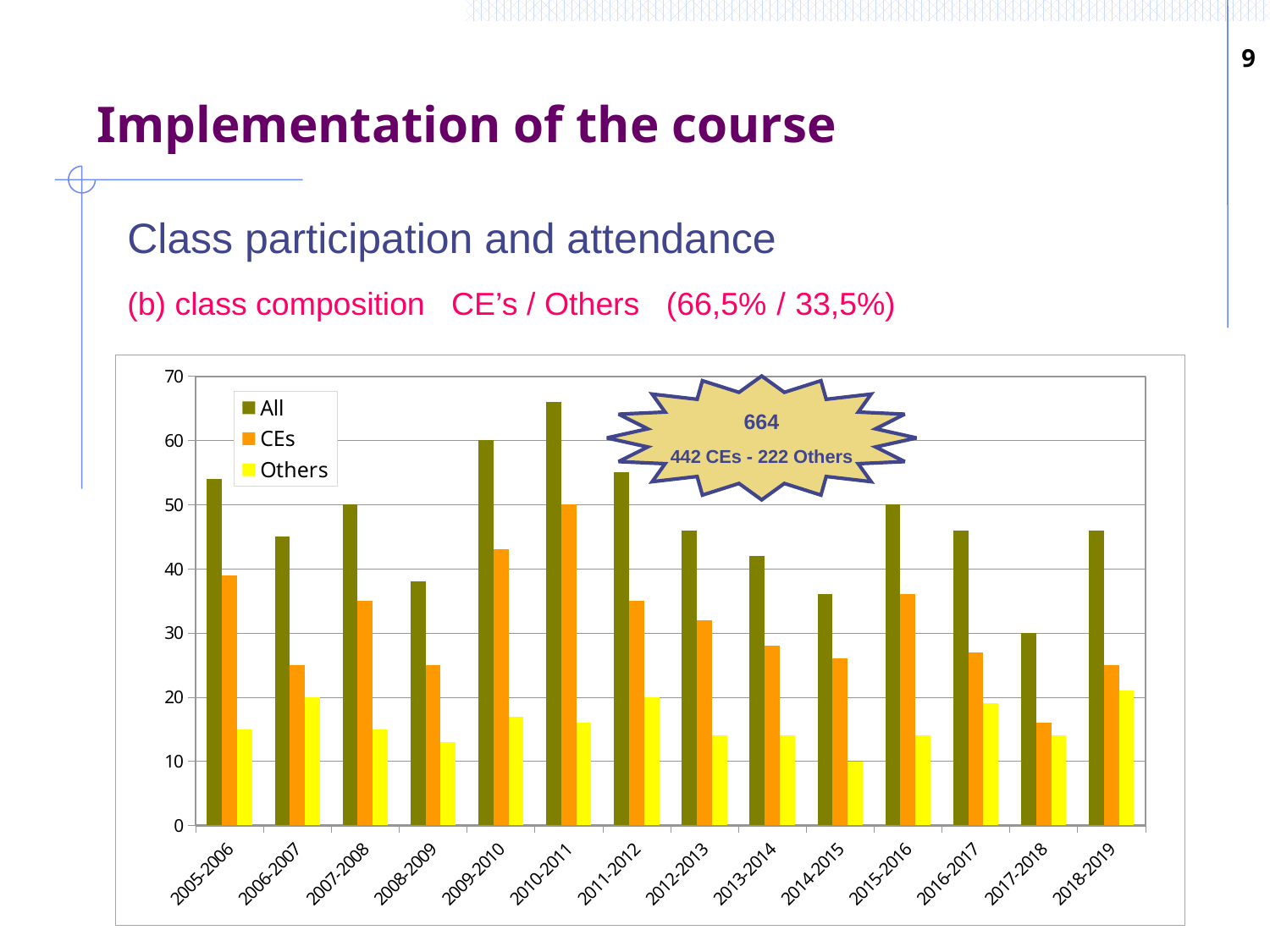
Which academic year has the highest value for the CEs series? 2010-2011 Which academic year has the lowest value for the All series? 2017-2018 How many academic years are shown on the x axis? 14 How many series does the legend list? 3 Which is larger, the All value for 2012-2013 or the All value for 2013-2014? 2012-2013 What kind of chart is shown on the slide? bar chart Is the value for All in 2005-2006 greater or less than 50? greater Is the value for CEs in 2008-2009 greater or less than 30? less What is the value for All in 2009-2010? 60 Which academic year has the lowest value for the Others series? 2014-2015 Which academic year has the highest value for the All series? 2010-2011 What is the value for CEs in 2010-2011? 50